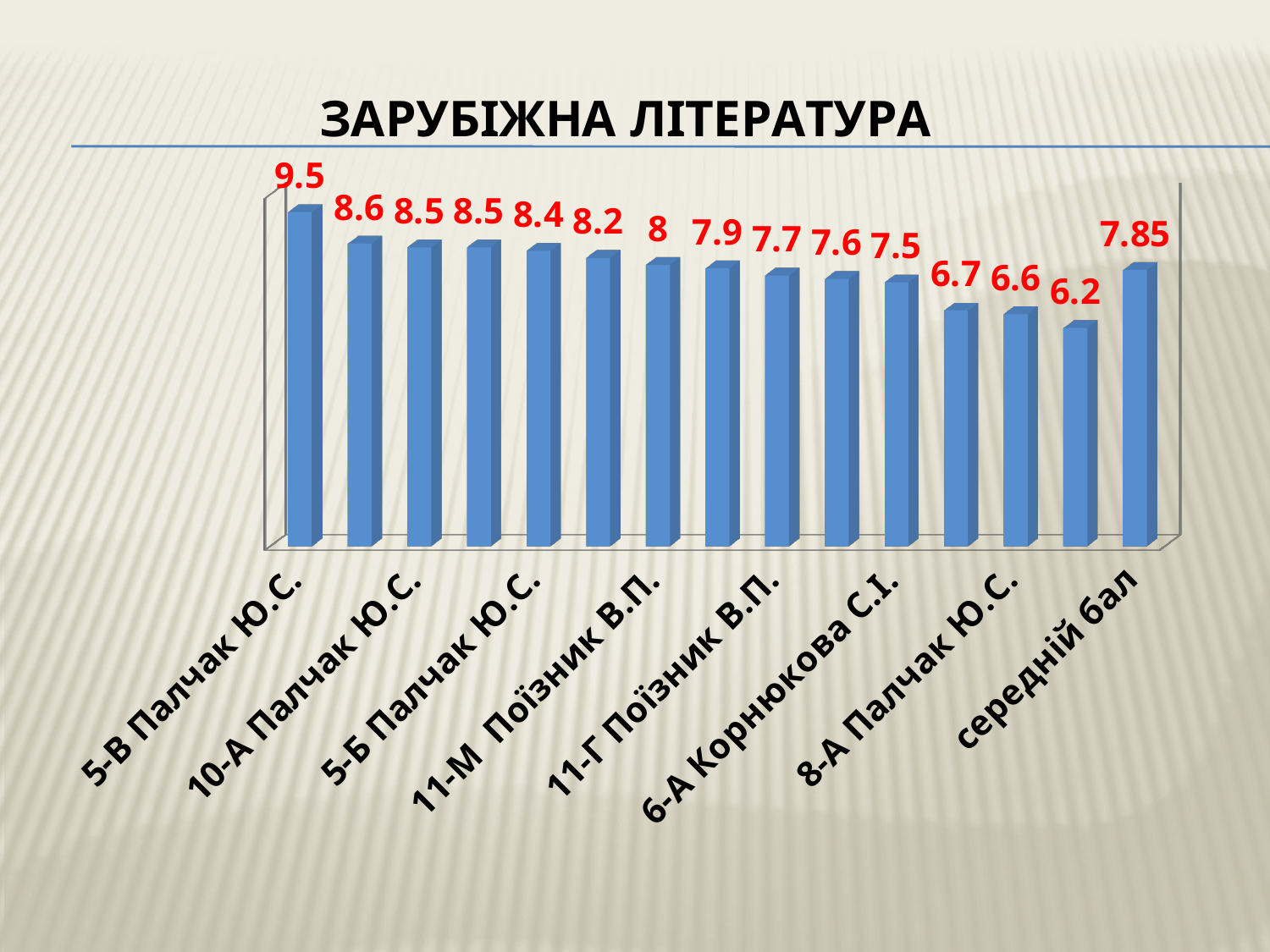
What is the value for середній бал? 7.85 What is the title of the chart? ЗАРУБІЖНА ЛІТЕРАТУРА What is the value for 10-А Палчак Ю.С.? 8.5 What is the value for 6-А Корнюкова С.І.? 7.5 What is the value for 5-В Палчак Ю.С.? 9.5 What kind of chart is shown on the slide? bar chart How many bars are plotted in the chart? 15 Which category has the highest value? 5-В Палчак Ю.С. What is the difference between the value for 5-В Палчак Ю.С. and середній бал? 1.65 Which is larger, the value for 8-А Палчак Ю.С. or the value for 11-Г Поїзник В.П.? 11-Г Поїзник В.П. What is the lowest value shown in the chart? 6.2 What is the value for 11-М Поїзник В.П.? 8